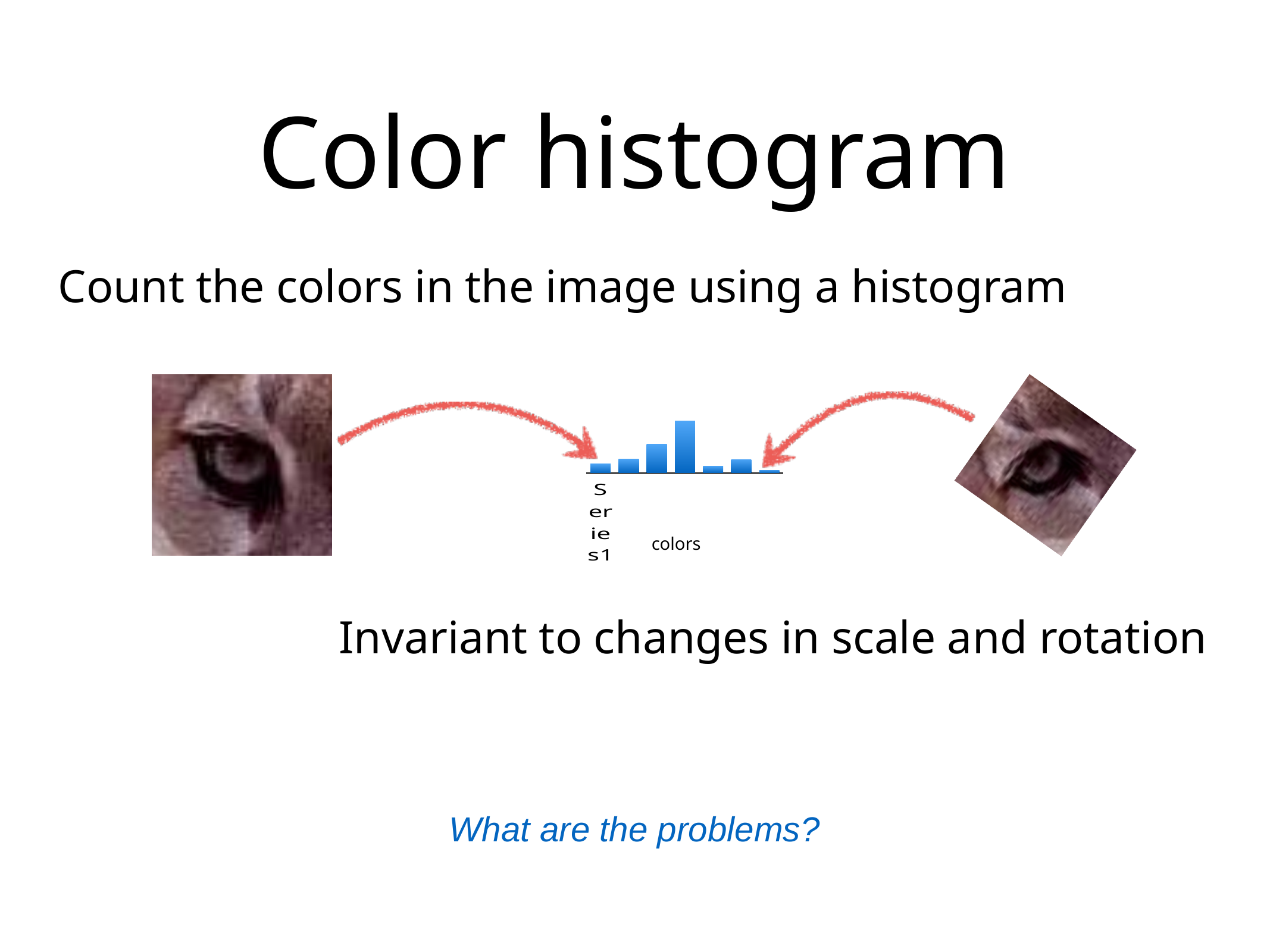
Which bar in the chart is the shortest, counting from the left? the last (seventh) bar What kind of chart is shown on the slide? bar chart Do the bar heights rise or fall from the first bar to the fourth bar? rise Is the third bar from the left taller or shorter than the fifth bar? taller How many bars does the chart contain? 7 What is the label shown on the horizontal axis of the chart? colors What series name is printed below the chart's first bar? Series1 Is the fourth bar from the left taller or shorter than the first bar? taller Which bar in the chart is the tallest, counting from the left? the fourth bar